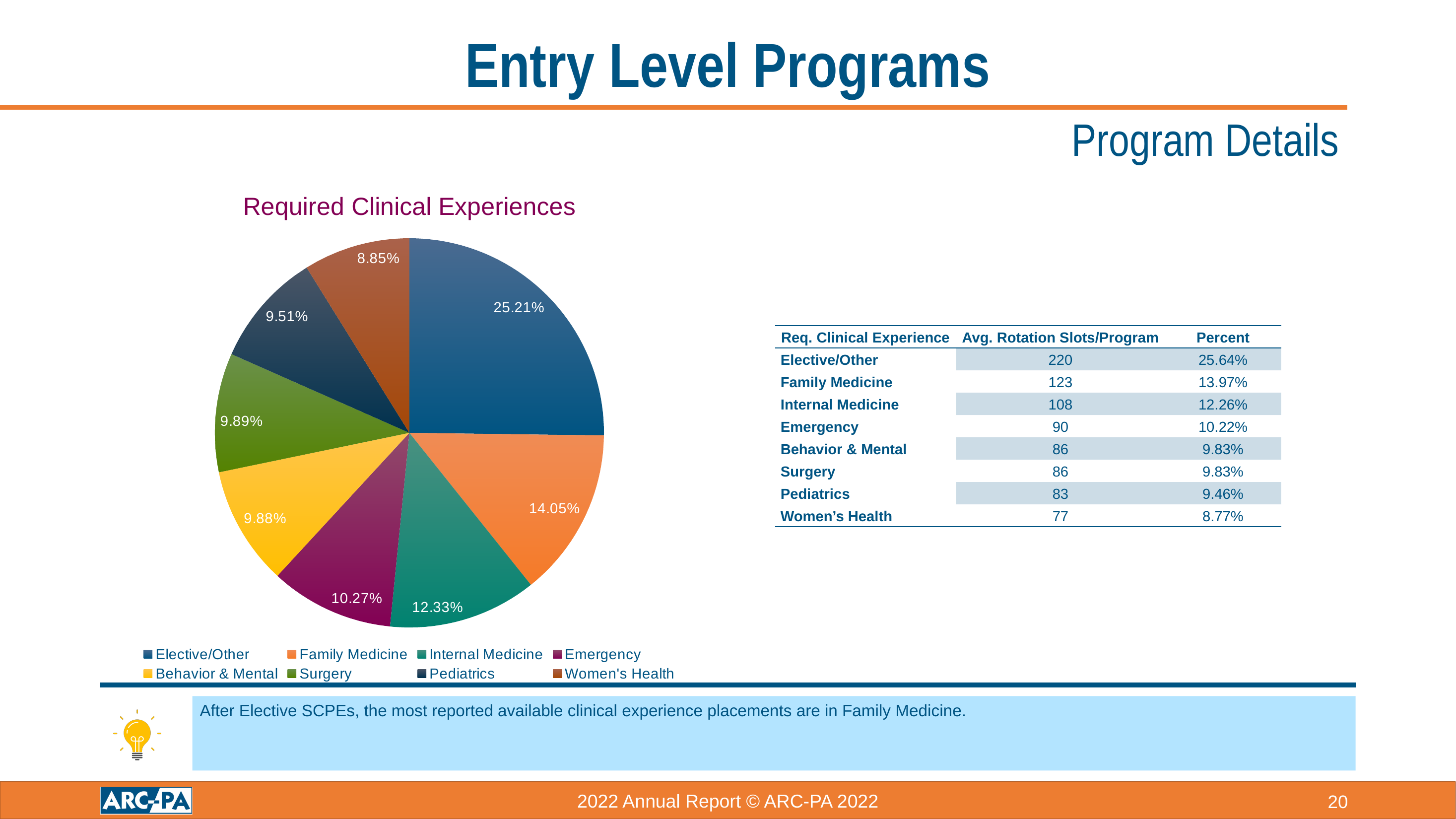
In the pie chart, what percentage is shown for Elective/Other? 25.21% In the pie chart, what percentage is shown for Family Medicine? 14.05% What type of chart is shown under the title "Required Clinical Experiences"? pie chart How many categories does the pie chart's legend list? 8 In the pie chart, what is the difference between the Elective/Other and Family Medicine percentages? 11.16% In the pie chart, what percentage is shown for Women's Health? 8.85% In the pie chart, which slice is larger: Internal Medicine or Emergency? Internal Medicine In the pie chart, what percentage is shown for Pediatrics? 9.51% Which category has the smallest slice in the pie chart? Women's Health In the pie chart, what percentage is shown for Internal Medicine? 12.33% In the pie chart, what percentage is shown for Emergency? 10.27% Which category has the largest slice in the pie chart? Elective/Other